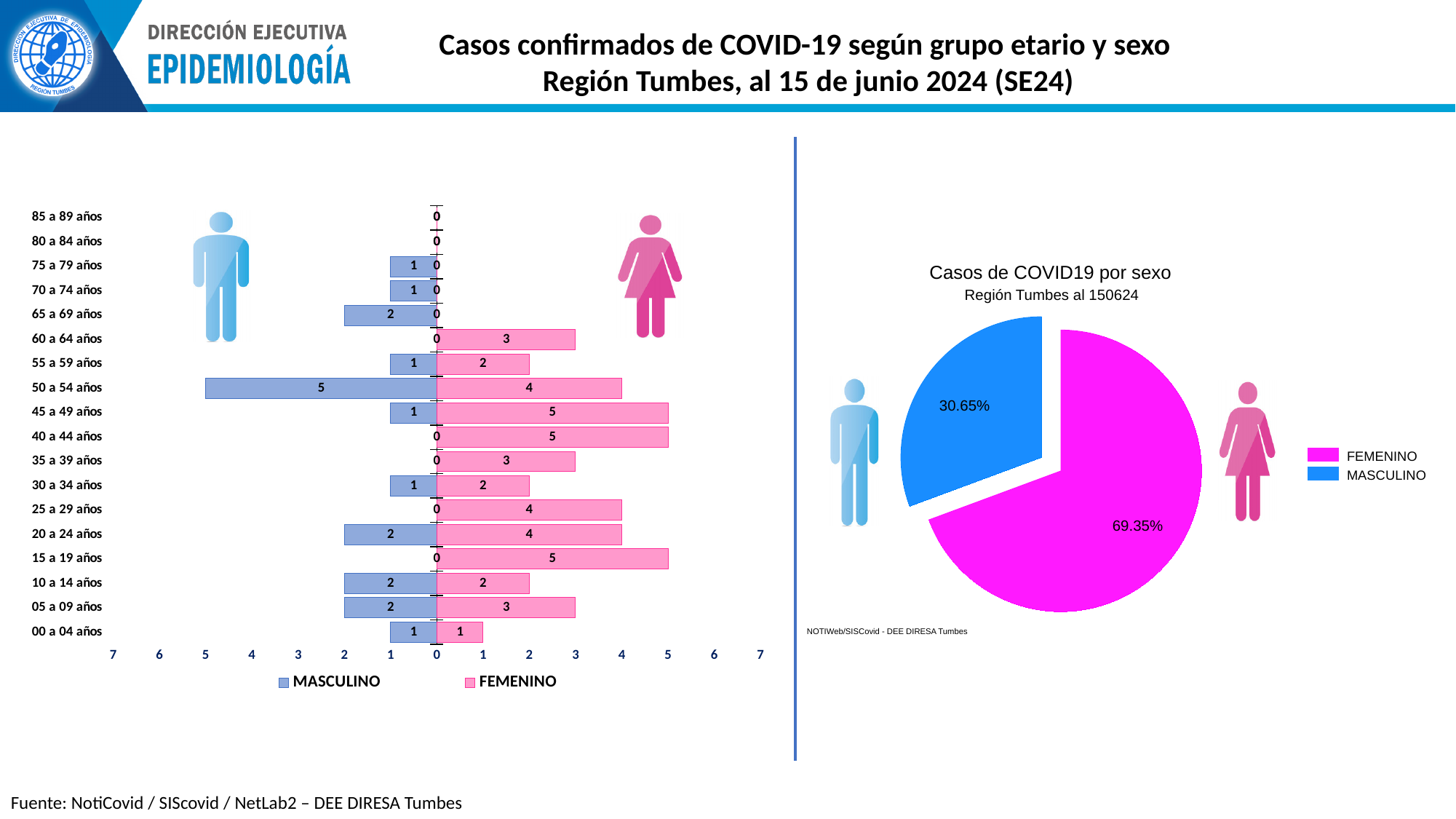
In the left chart, for the 50 a 54 años age group, which series has more cases, MASCULINO or FEMENINO? MASCULINO In the left chart, which age group has the highest number of MASCULINO cases? 50 a 54 años In the pie chart 'Casos de COVID19 por sexo', which colour represents FEMENINO? Magenta (pink) In the left chart, how many MASCULINO cases are shown for the 50 a 54 años age group? 5 In the pie chart 'Casos de COVID19 por sexo', what share of cases is MASCULINO? 30.65% What kind of chart is the left chart showing cases by age group and sex? Bar chart In the left chart, how many FEMENINO cases are shown for the 60 a 64 años age group? 3 In the left chart, what is the difference between the FEMENINO and MASCULINO cases for the 45 a 49 años age group? 4 In the left chart, how many age groups are listed on the vertical axis? 18 In the left chart, how many series does the legend list? 2 In the left chart, how many FEMENINO cases are shown for the 15 a 19 años age group? 5 In the pie chart 'Casos de COVID19 por sexo', what share of cases is FEMENINO? 69.35%